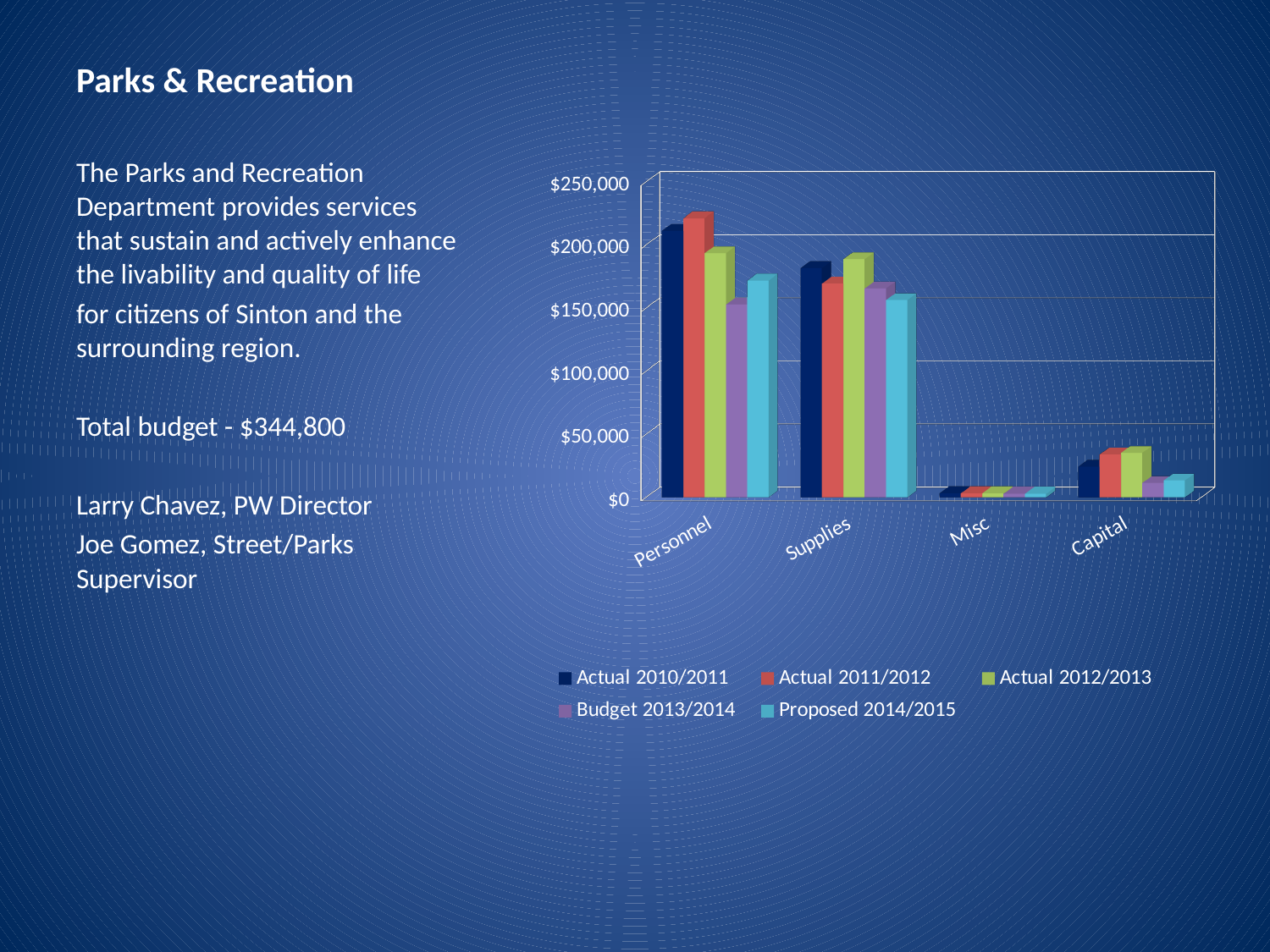
Is the Actual 2011/2012 value for Personnel greater or less than $200,000? greater For the Budget 2013/2014 series, which is larger: Capital or Misc? Capital Which category has the highest value for the Actual 2011/2012 series? Personnel What kind of chart is shown on the slide? bar chart Is the Actual 2011/2012 value for Capital greater or less than $50,000? less Which series is shown in dark blue in the chart's legend? Actual 2010/2011 For the Actual 2010/2011 series, which is larger: Personnel or Supplies? Personnel Which category has the lowest values across all series in the chart? Misc How many series does the chart's legend list? 5 Is the Proposed 2014/2015 value for Personnel greater or less than $150,000? greater How many categories are shown on the x axis of the chart? 4